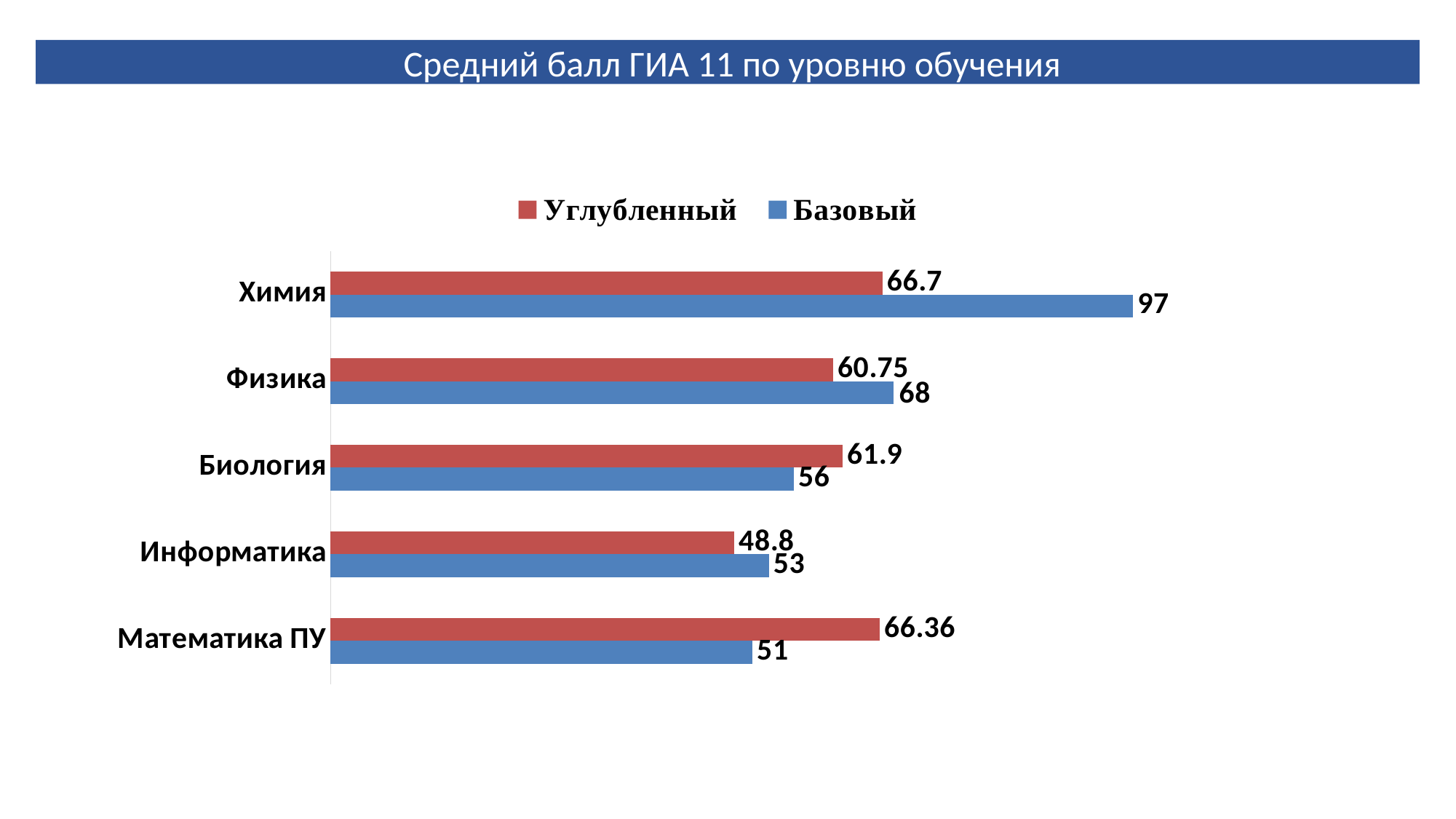
What is the Углубленный value for Информатика? 48.8 How many series does the legend list? 2 What is the Углубленный value for Химия? 66.7 What is the difference between the Базовый and Углубленный values for Химия? 30.3 Which is larger for Физика, the Углубленный value or the Базовый value? Базовый What is the Базовый value for Математика ПУ? 51 What is the difference between the Углубленный and Базовый values for Математика ПУ? 15.36 Which category has the lowest Углубленный value? Информатика Which category has the highest Базовый value? Химия Which is larger for Биология, the Углубленный value or the Базовый value? Углубленный How many categories are shown on the chart? 5 What kind of chart is shown on the slide? Bar chart